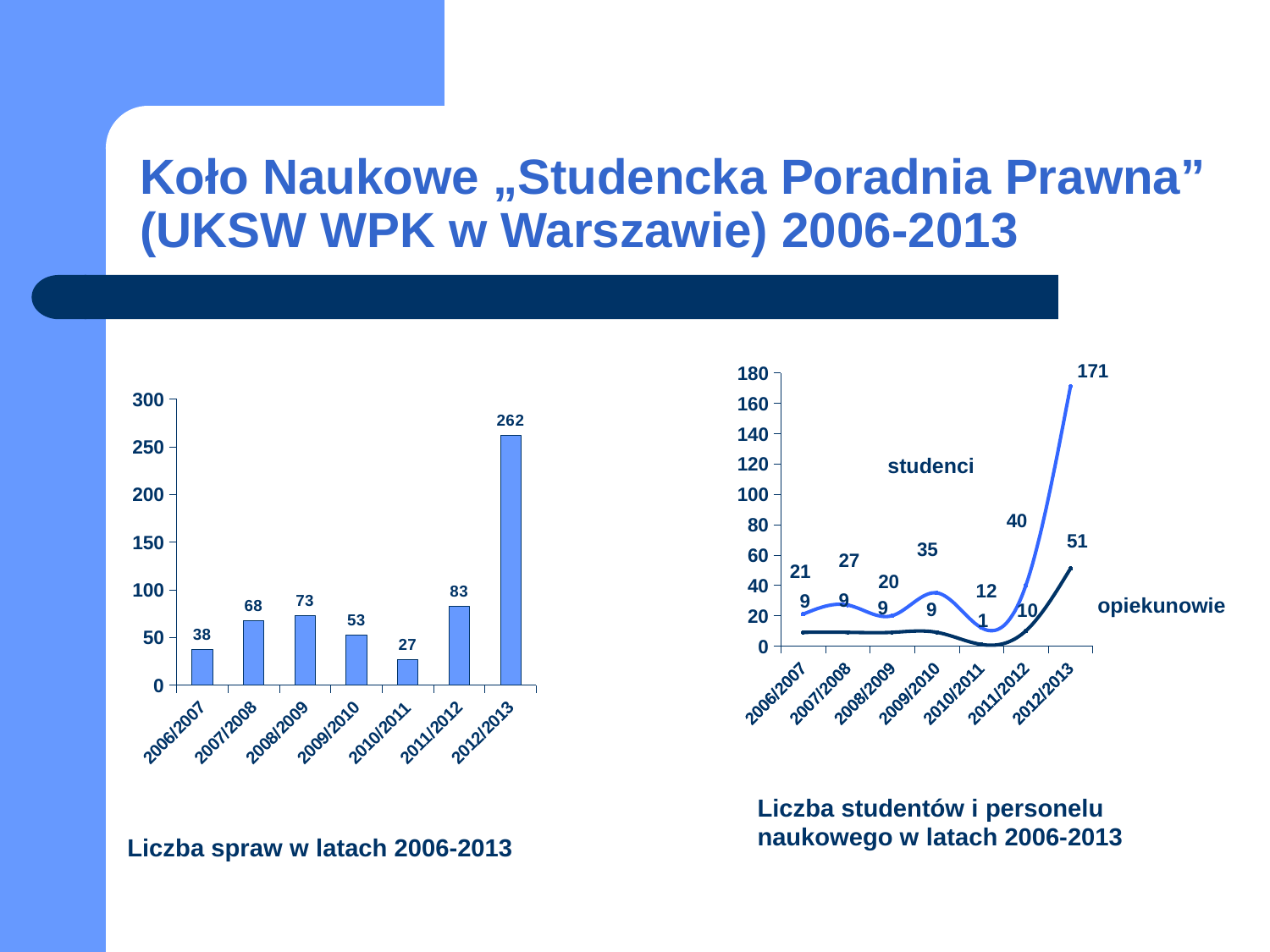
What kind of chart is the left chart (Liczba spraw w latach 2006-2013)? bar chart In the right chart (Liczba studentów i personelu naukowego), how many series are plotted? 2 In the left chart (Liczba spraw w latach 2006-2013), how many years are shown on the x axis? 7 What kind of chart is the right chart (Liczba studentów i personelu naukowego)? line chart In the left chart (Liczba spraw w latach 2006-2013), which is larger, the value for 2007/2008 or 2008/2009? 2008/2009 In the left chart (Liczba spraw w latach 2006-2013), which year has the lowest value? 2010/2011 In the left chart (Liczba spraw w latach 2006-2013), what is the value for 2012/2013? 262 In the right chart (Liczba studentów i personelu naukowego), what is the value for opiekunowie in 2010/2011? 1 In the right chart (Liczba studentów i personelu naukowego), what is the difference between studenci and opiekunowie in 2011/2012? 30 In the right chart (Liczba studentów i personelu naukowego), what is the value for studenci in 2012/2013? 171 In the left chart (Liczba spraw w latach 2006-2013), what is the difference between the values for 2011/2012 and 2010/2011? 56 In the right chart (Liczba studentów i personelu naukowego), which year has the highest value for studenci? 2012/2013